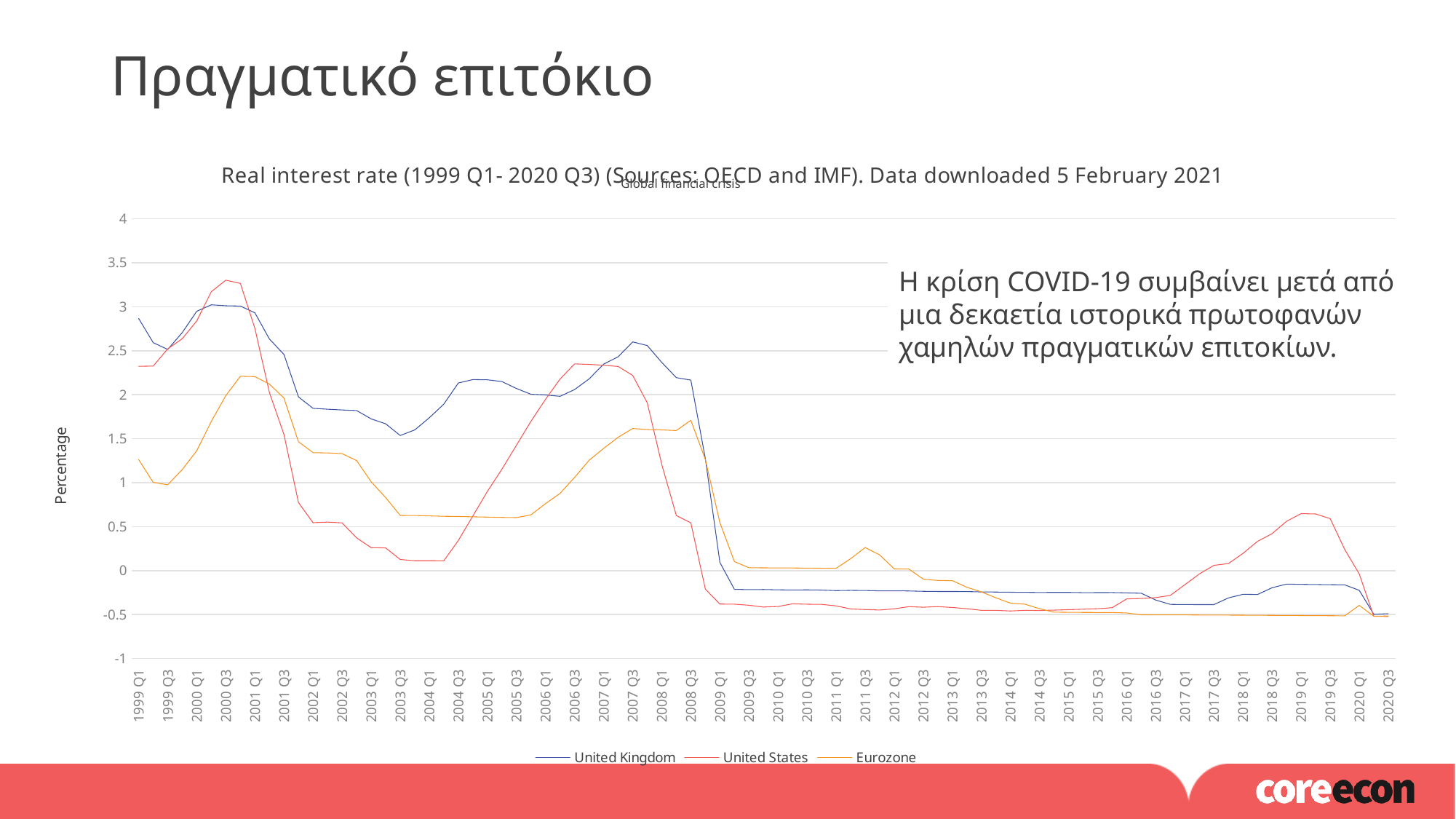
How many series does the legend list? 3 Does the United Kingdom series rise or fall between 2007 Q3 and 2009 Q1? Fall In 2019 Q1, which is larger: the value for United States or for United Kingdom? United States Is the value for United States in 2000 Q3 greater or less than 3? greater What kind of chart is shown on the slide? Line chart Which series has the lowest value in 2005 Q1? Eurozone Is the value for Eurozone in 1999 Q1 greater or less than 1? greater Which series has the highest value in 2000 Q3? United States Is the value for United Kingdom in 2007 Q3 greater or less than 2? greater What is the label on the vertical axis? Percentage Which series are listed in the legend? United Kingdom, United States, Eurozone